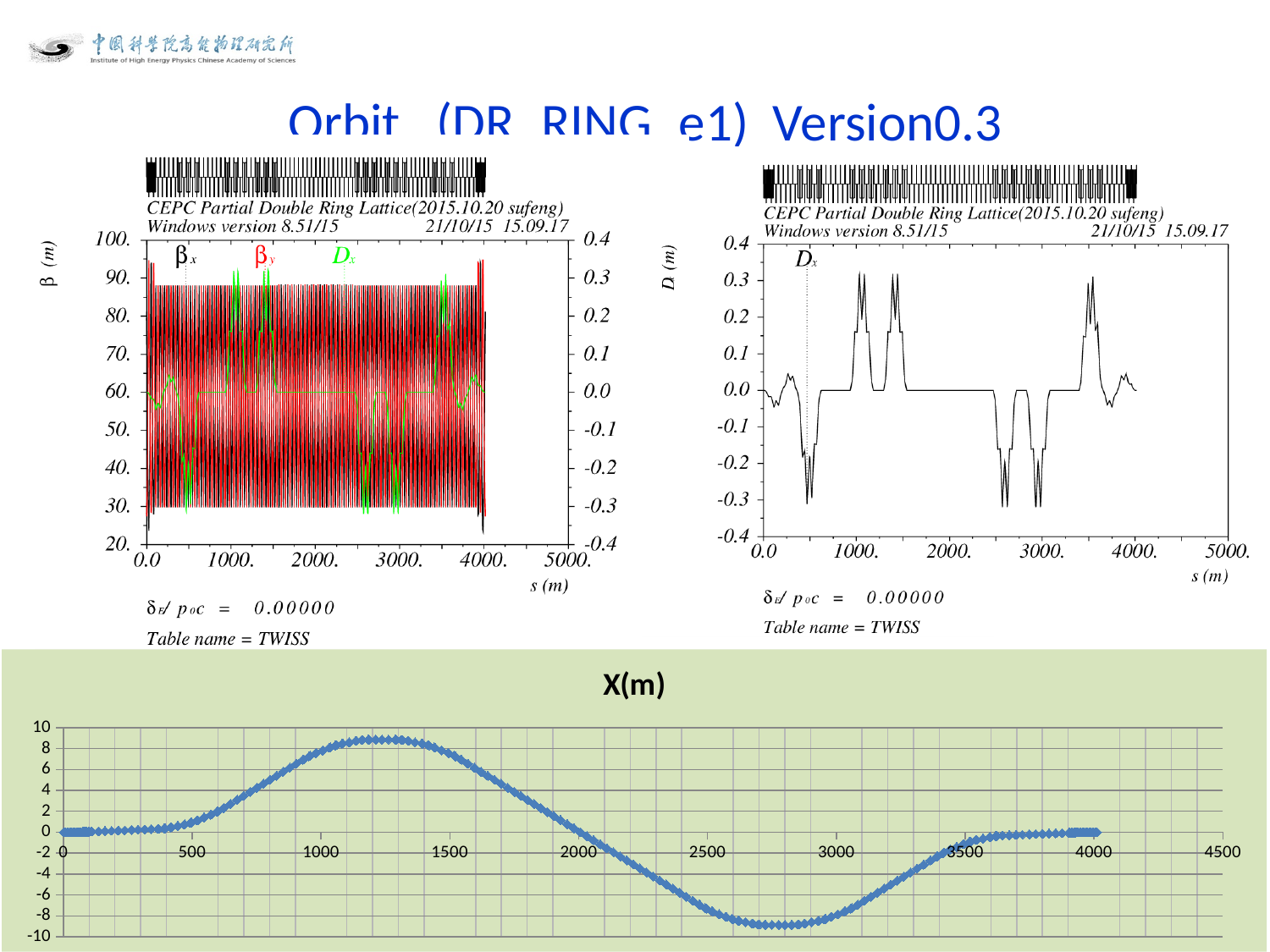
What kind of chart is the bottom chart titled X(m)? line chart How many series are labelled in the top-left chart? 3 In the top-right chart of Dx versus s, is the value at s = 2600 greater or less than -0.2? less In the top-left chart, which colour is used for the βy series? red What is the title of the chart at the bottom of the slide? X(m) In the top-right chart of Dx versus s, is the value at s = 2000 greater or less than 0.1? less In the bottom chart titled X(m), is the value at x = 1200 greater or less than 5? greater In the bottom chart titled X(m), do the values rise or fall as x goes from 500 to 1200? rise In the bottom chart titled X(m), what is the highest value shown on the vertical axis? 10 In the bottom chart titled X(m), do the values rise or fall as x goes from 1200 to 2700? fall